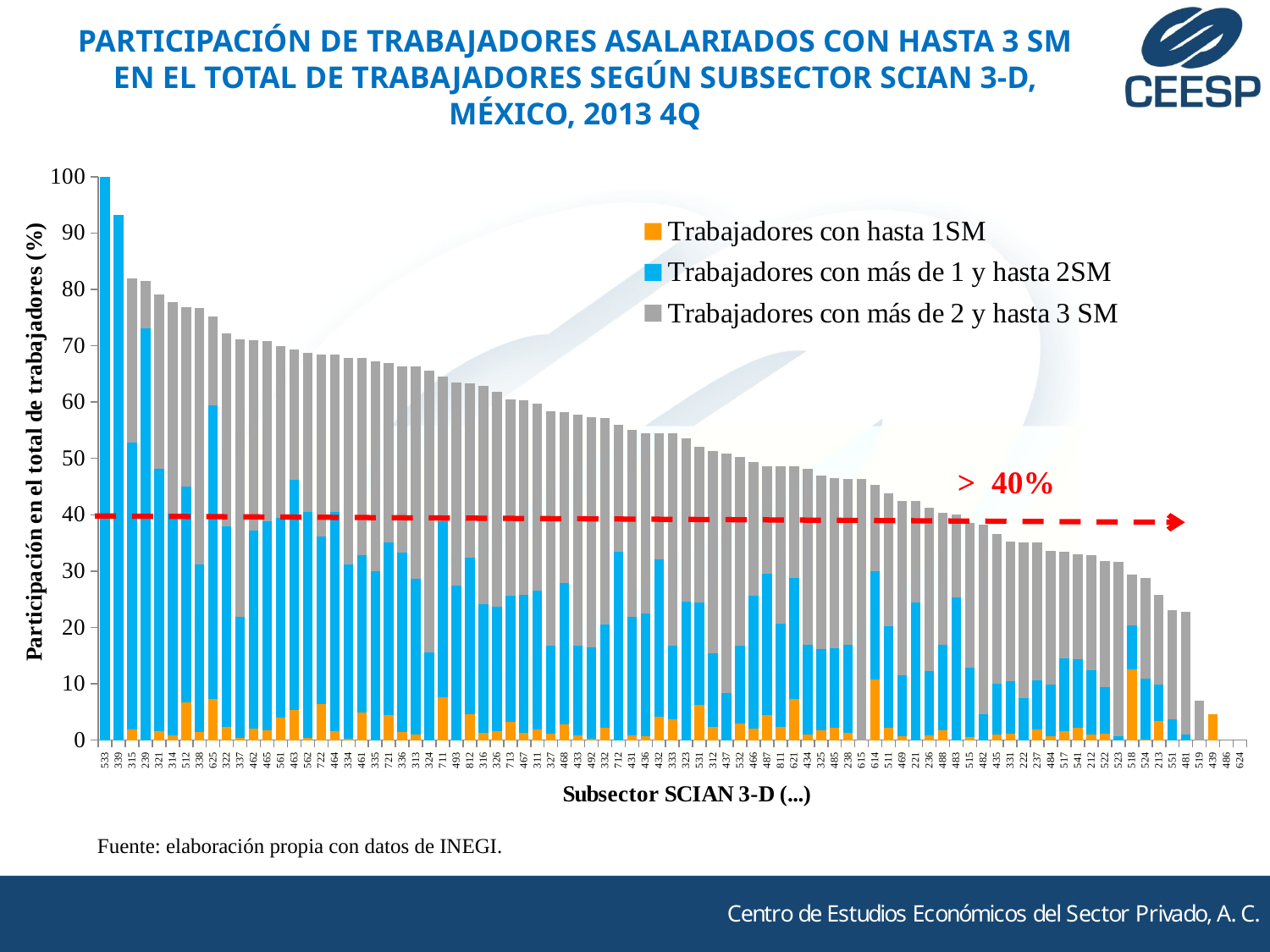
Is the total value for subsector 315 greater or less than 80? greater How many series does the legend list? 3 What kind of chart is shown on the slide? Stacked bar chart Is the value of 'Trabajadores con más de 1 y hasta 2SM' for subsector 239 greater or less than 70? greater Is the total value for subsector 339 greater or less than 90? greater Which has a larger total value, subsector 533 or subsector 339? 533 What percentage is written next to the red dashed horizontal line? > 40% Which subsector has the highest total share of workers with up to 3 SM? 533 What is the title of the y axis? Participación en el total de trabajadores (%) Do the total bar heights rise or fall moving from left to right along the x axis? fall